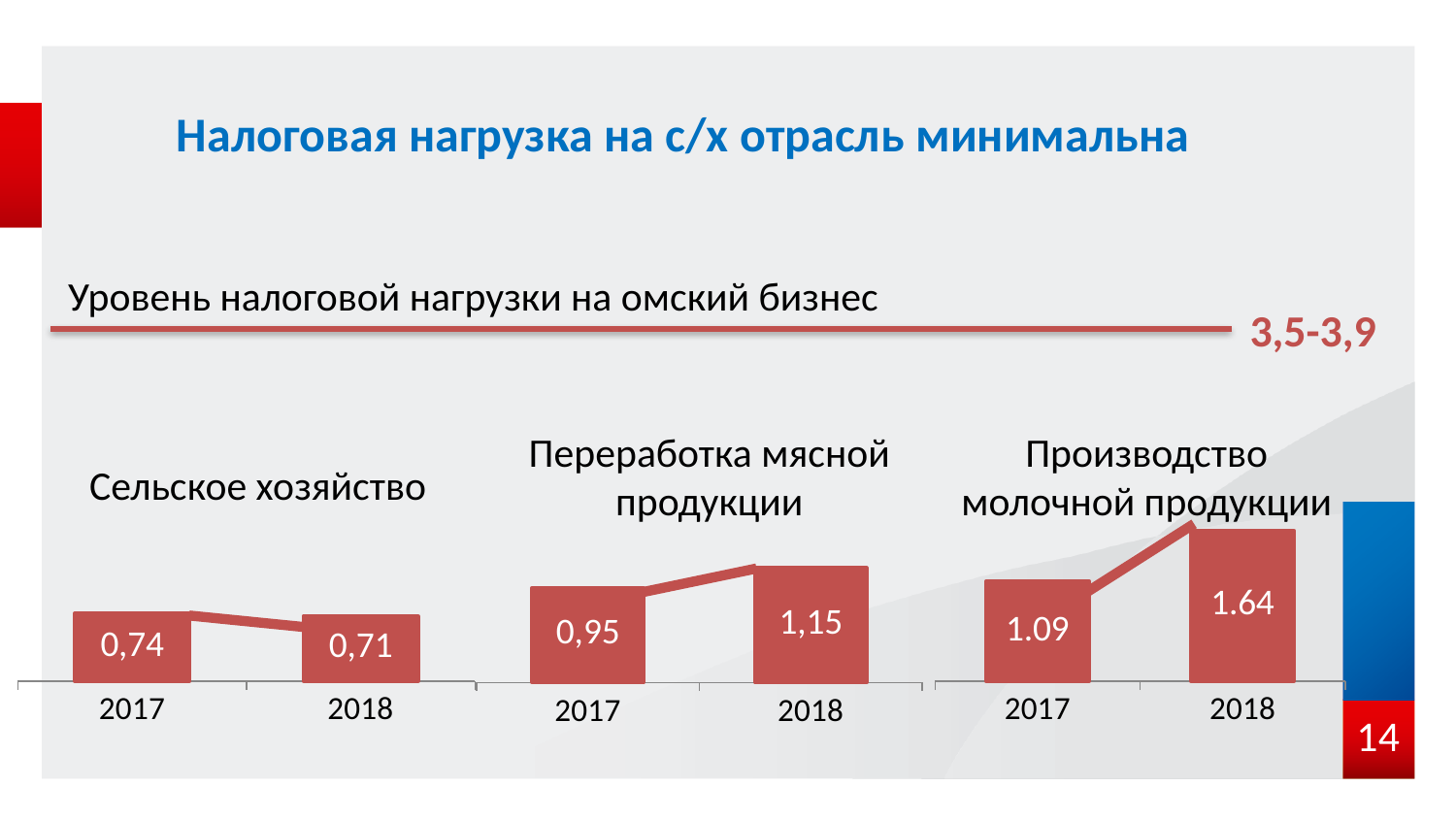
In the "Сельское хозяйство" chart, do the values rise or fall from 2017 to 2018? fall In the "Переработка мясной продукции" chart, what is the difference between the 2018 and 2017 values? 0,20 In the "Сельское хозяйство" chart, what is the value for 2017? 0,74 In the "Переработка мясной продукции" chart, what is the value for 2018? 1,15 In the "Производство молочной продукции" chart, what is the value for 2018? 1.64 How many bars are shown in the "Сельское хозяйство" chart? 2 In the "Переработка мясной продукции" chart, which year has the higher value, 2017 or 2018? 2018 In the "Сельское хозяйство" chart, what is the value for 2018? 0,71 In the "Переработка мясной продукции" chart, do the values rise or fall from 2017 to 2018? rise What kind of chart is the "Производство молочной продукции" chart? bar chart In the "Производство молочной продукции" chart, what is the difference between the 2018 and 2017 values? 0.55 In the "Производство молочной продукции" chart, what is the value for 2017? 1.09